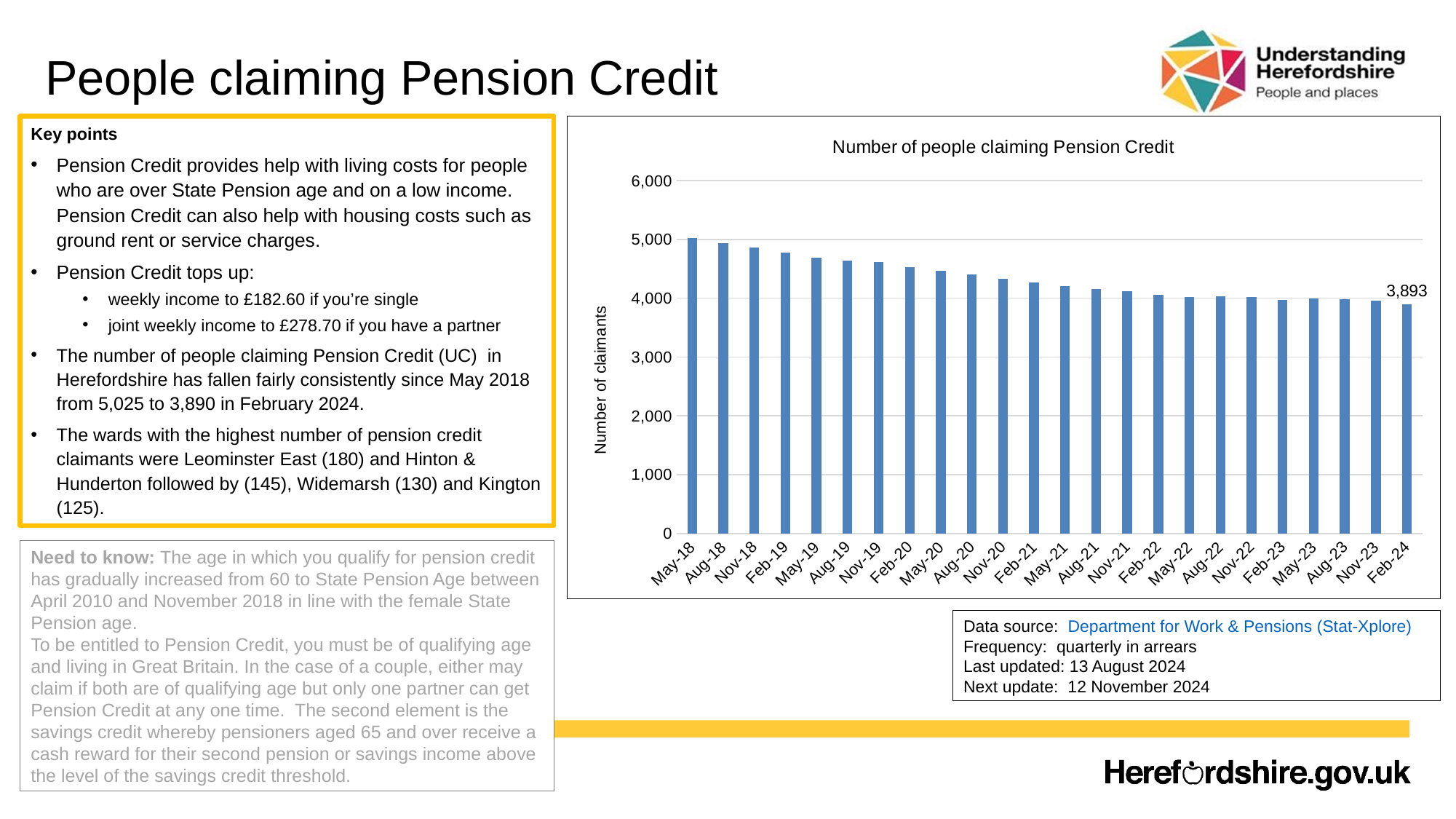
Is the value for May-18 greater or less than 4,000? greater Do the values in the chart generally rise or fall from May-18 to Feb-24? Fall What is the label on the vertical axis of the chart? Number of claimants What is the number of people claiming Pension Credit in Feb-24 according to the data label on the chart? 3,893 What is the title of the chart? Number of people claiming Pension Credit Which is larger, the value for Aug-19 or the value for Aug-22? Aug-19 Which period has the highest number of claimants in the chart? May-18 Is the value for Feb-24 greater or less than 4,000? less Is the value for Feb-22 greater or less than 5,000? less What kind of chart is shown on the slide? Bar chart How many bars (time periods) are plotted in the chart? 24 Which period has the lowest number of claimants in the chart? Feb-24